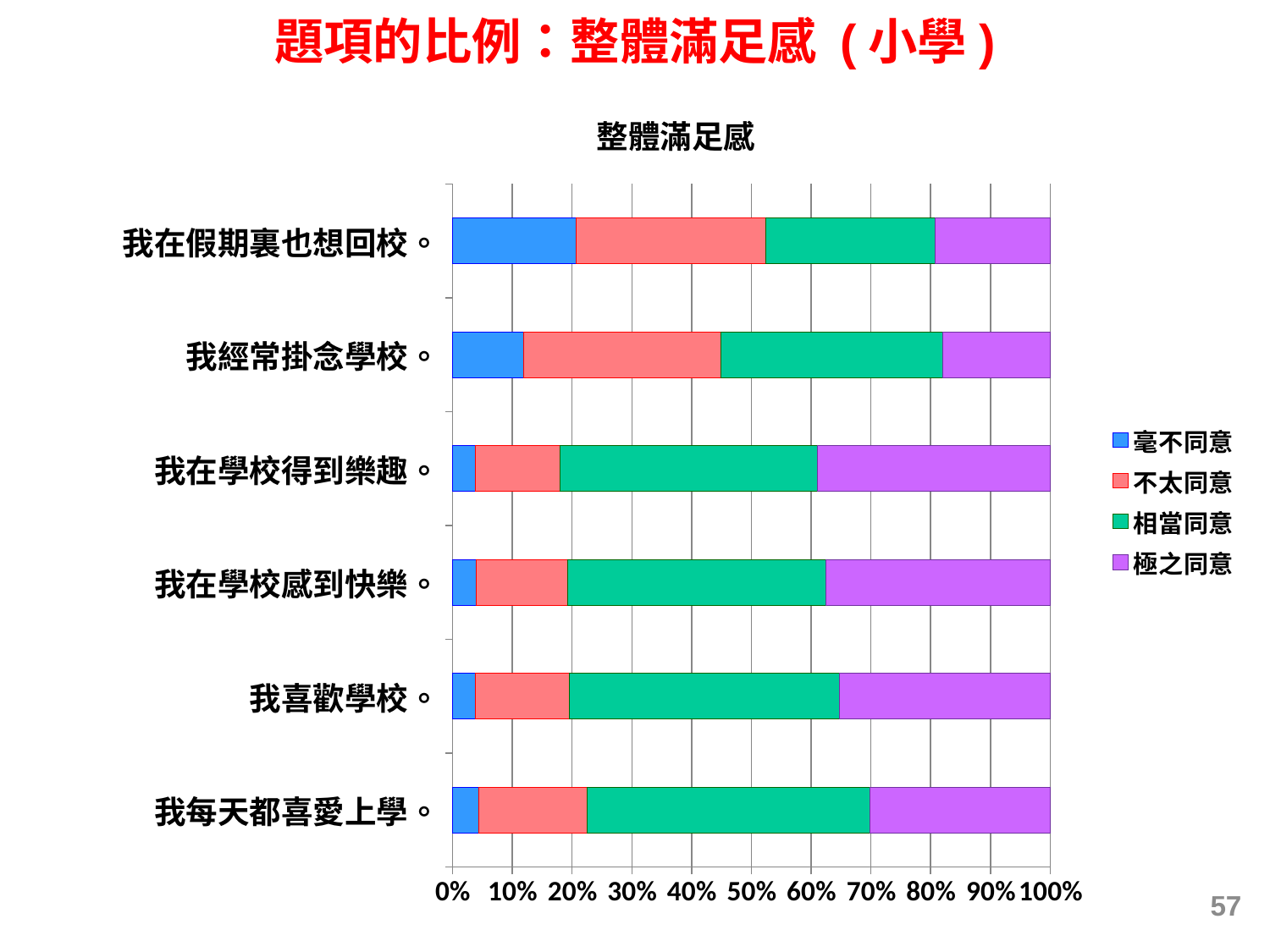
Which statement has the largest 毫不同意 share? 我在假期裏也想回校 How many series does the legend list? 4 Is the 毫不同意 share for 我在假期裏也想回校 greater or less than 10%? greater What is the title of the chart? 整體滿足感 Is the 毫不同意 share for 我在學校感到快樂 greater or less than 10%? less What kind of chart is shown on the slide? Stacked bar chart Which has the larger 極之同意 share: 我在學校得到樂趣 or 我經常掛念學校? 我在學校得到樂趣 Which has the larger 不太同意 share: 我經常掛念學校 or 我在學校得到樂趣? 我經常掛念學校 Which legend entry is shown in green? 相當同意 Is the 毫不同意 share for 我喜歡學校 greater or less than 10%? less Which has the larger 毫不同意 share: 我在假期裏也想回校 or 我喜歡學校? 我在假期裏也想回校 How many statements (categories) are plotted in the chart? 6